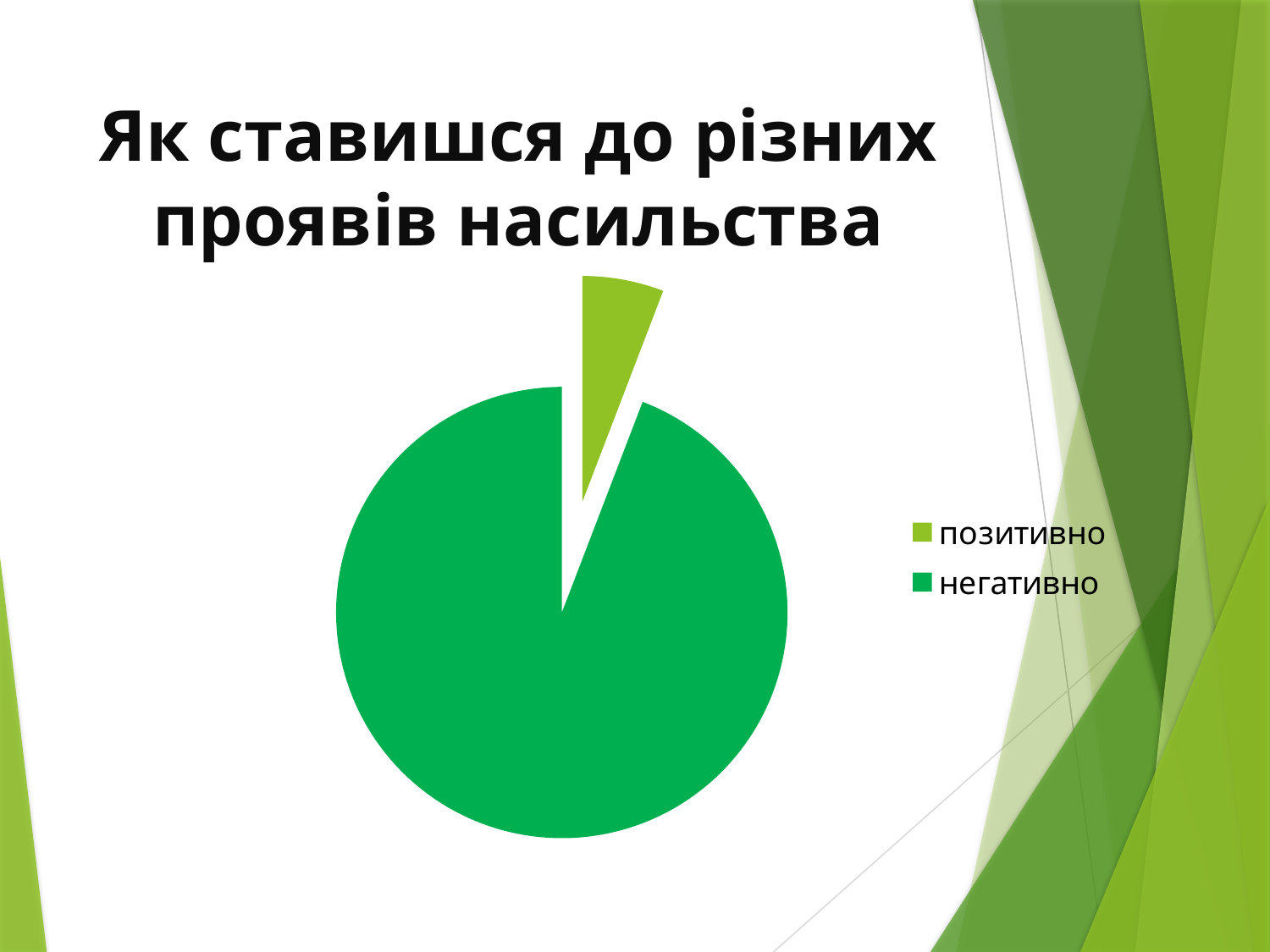
Which legend entry is shown in the lighter green colour? позитивно How many entries does the legend list? 2 What is the title of the slide above the chart? Як ставишся до різних проявів насильства Which category has the largest slice of the pie? негативно Does the slice for негативно take up more or less than half of the pie? more How many slices does the pie chart have? 2 Which slice is larger, позитивно or негативно? негативно Which category has the smallest slice of the pie? позитивно What kind of chart is shown on the slide? pie chart